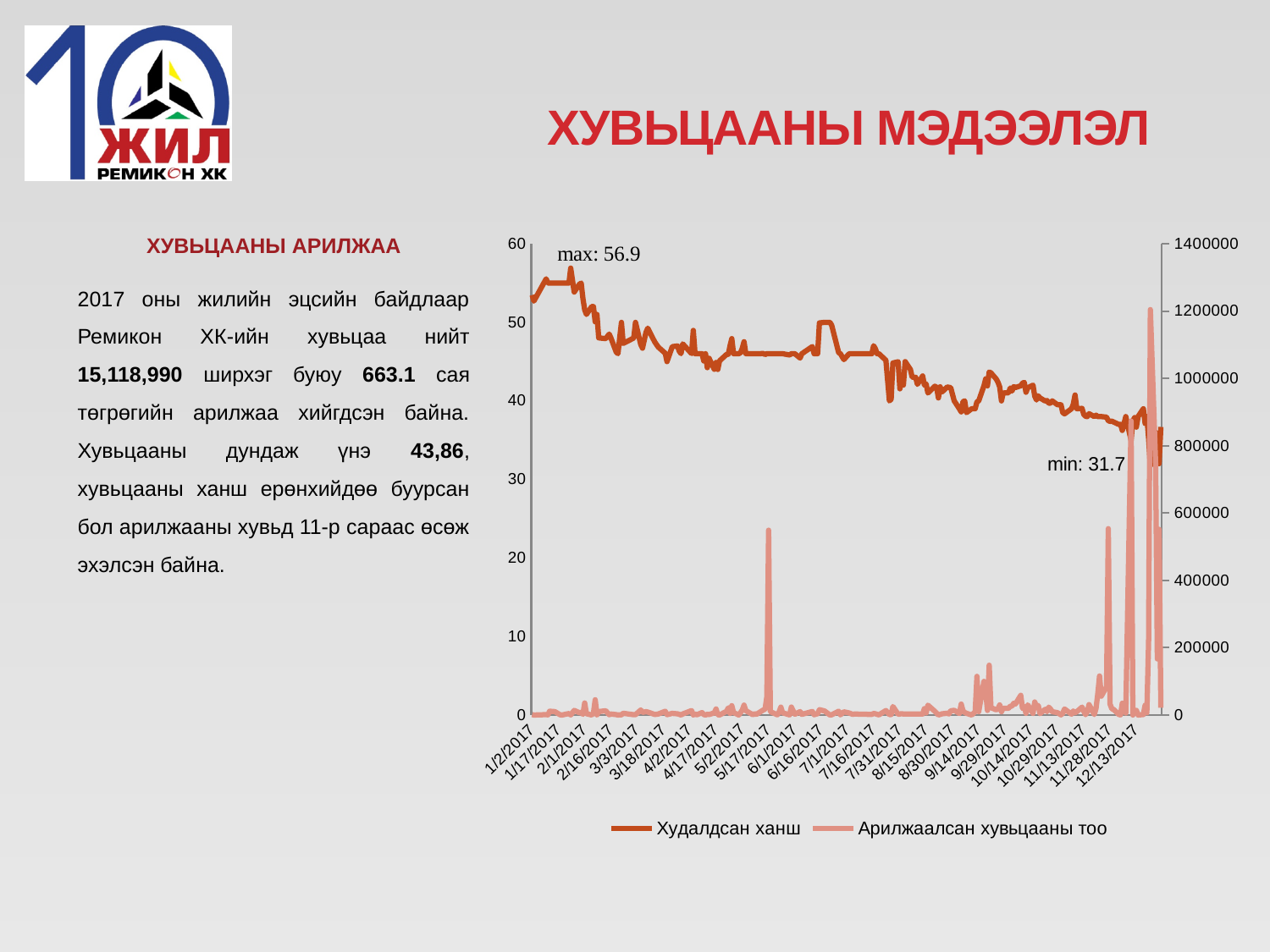
What is the minimum value annotated for the Худалдсан ханш series? 31.7 Is the Арилжаалсан хувьцааны тоо spike near 5/17/2017 greater or less than 800000? less Is the Худалдсан ханш value at 1/2/2017 greater or less than 50? greater What is the maximum value annotated for the Худалдсан ханш series? 56.9 What kind of chart is shown on the slide? line chart Which is larger: the Худалдсан ханш value at 1/2/2017 or at 12/13/2017? 1/2/2017 What are the two legend entries of the chart? Худалдсан ханш, Арилжаалсан хувьцааны тоо How many series does the chart legend list? 2 What is the difference between the annotated max (56.9) and min (31.7) of the Худалдсан ханш series? 25.2 Is the highest peak of the Арилжаалсан хувьцааны тоо series (in December) greater or less than 1000000? greater What is the highest tick value shown on the right-hand axis? 1400000 Does the Худалдсан ханш series generally rise or fall from January to December 2017? fall